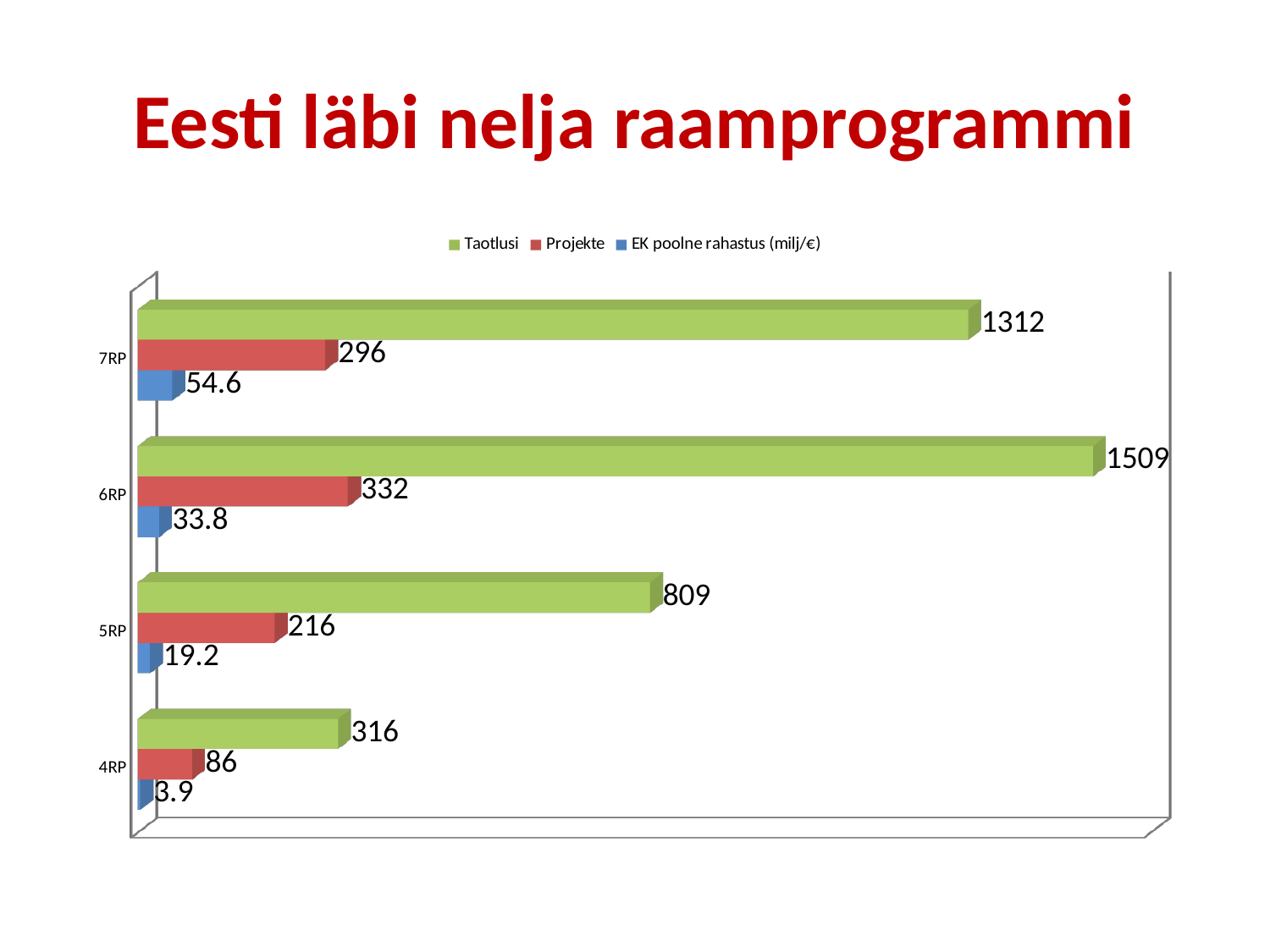
What is the difference between the Projekte values for 5RP and 4RP? 130 How many categories are shown on the chart? 4 Which is larger, the EK poolne rahastus (milj/€) value for 7RP or for 6RP? 7RP What is the title of the slide? Eesti läbi nelja raamprogrammi Which category has the highest Taotlusi value? 6RP How many series does the legend list? 3 What is the Projekte value for 6RP? 332 What is the EK poolne rahastus (milj/€) value for 4RP? 3.9 What is the difference between the Taotlusi values for 6RP and 7RP? 197 What is the Taotlusi value for 7RP? 1312 Which category has the lowest Projekte value? 4RP What kind of chart is shown on the slide? bar chart